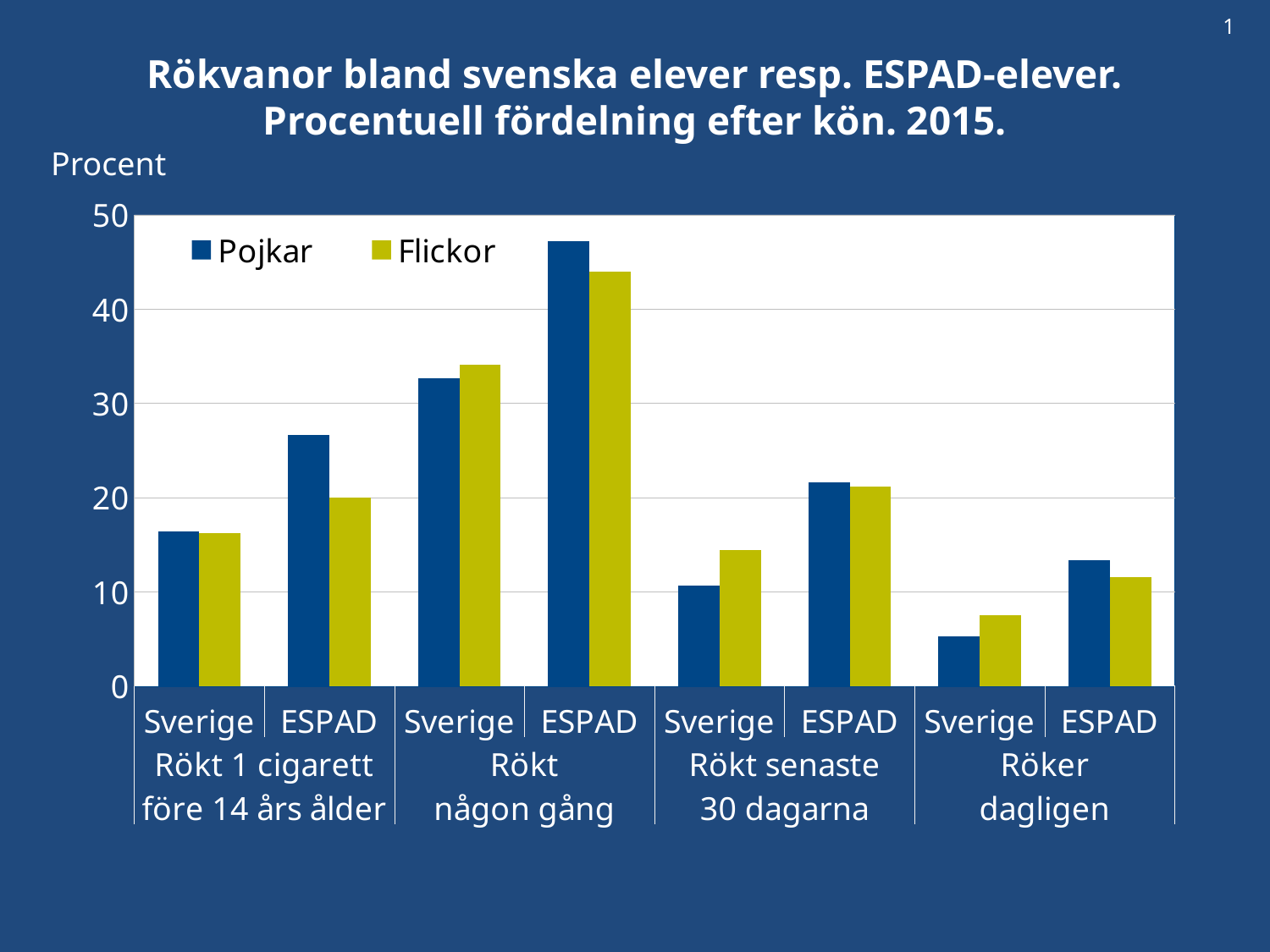
Under 'Rökt 1 cigarett före 14 års ålder' in ESPAD, which is larger, Pojkar or Flickor? Pojkar What is the label on the vertical axis? Procent What kind of chart is shown on the slide? bar chart Under 'Rökt senaste 30 dagarna' in Sverige, which is larger, Pojkar or Flickor? Flickor Which bar is the lowest in the chart? Pojkar, Sverige, Röker dagligen What are the two series named in the legend? Pojkar and Flickor Is the value for Flickor in Sverige under 'Röker dagligen' greater or less than 10? less Which bar is the highest in the chart? Pojkar, ESPAD, Rökt någon gång How many series does the legend list? 2 Is the value for Flickor in Sverige under 'Rökt senaste 30 dagarna' greater or less than 20? less Is the value for Pojkar in ESPAD under 'Rökt 1 cigarett före 14 års ålder' greater or less than 20? greater